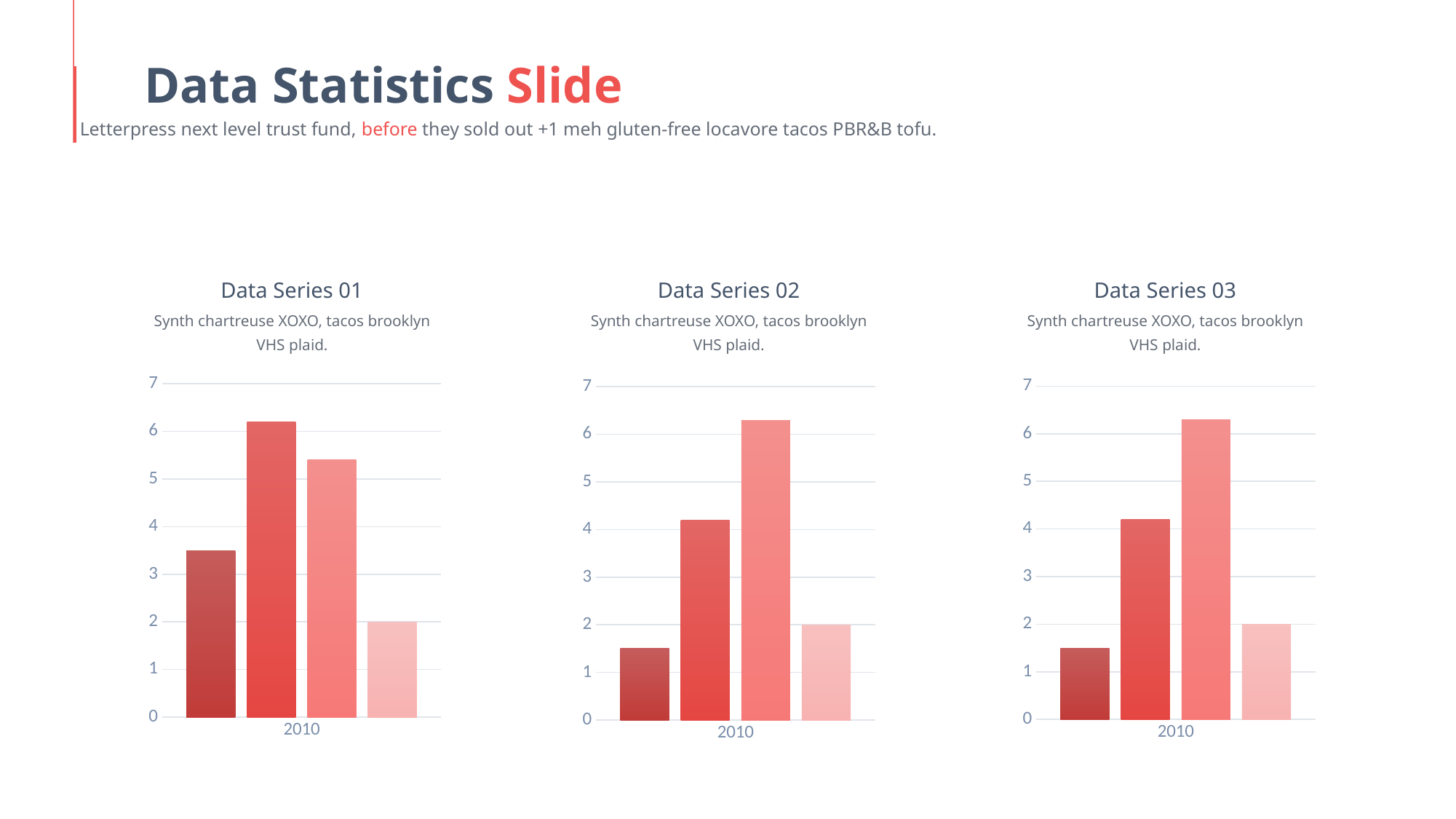
In the Data Series 01 chart, is the value of the first (leftmost) bar greater or less than 3? greater In the Data Series 02 chart, is the value of the first (leftmost) bar greater or less than 2? less In the Data Series 03 chart, which is larger, the second bar or the third bar? the third bar What kind of chart is the Data Series 01 chart? bar chart What is the highest value shown on the y axis of the Data Series 03 chart? 7 In the Data Series 01 chart, is the value of the second bar greater or less than 6? greater In the Data Series 02 chart, which bar is the tallest? the third bar What is the category label shown on the x axis of the Data Series 02 chart? 2010 In the Data Series 01 chart, which bar is the shortest? the fourth (rightmost) bar How many bars are plotted in the Data Series 01 chart? 4 In the Data Series 01 chart, which bar is the tallest? the second bar